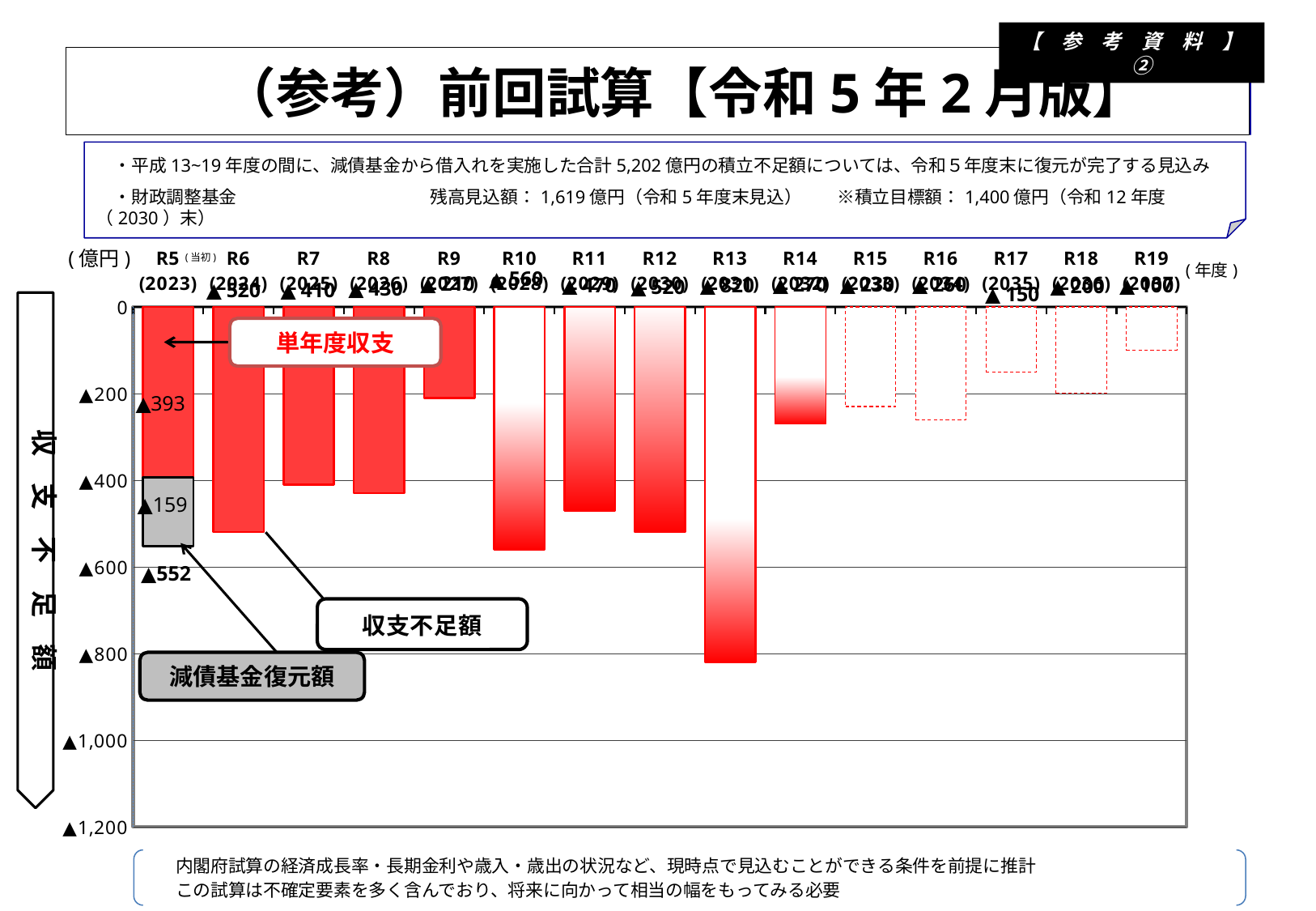
What is the value shown for R8 (2026)? ▲430 What is the value shown for R17 (2035)? ▲150 What is the value shown for R7 (2025)? ▲410 Which year has the largest shortfall (longest bar)? R13 (2031) What is the difference between the values for R6 (2024) and R7 (2025)? 110 What is the total value of the stacked bar for R5 (2023)? ▲552 What does the gray segment of the R5 (2023) bar represent? 減債基金復元額 Is the value for R9 (2027) greater or less than 400? less How many fiscal years are plotted on the x axis? 15 What is the value shown for R10 (2028)? ▲560 What is the value shown for R6 (2024)? ▲520 Is the value for R13 (2031) greater or less than 600? greater